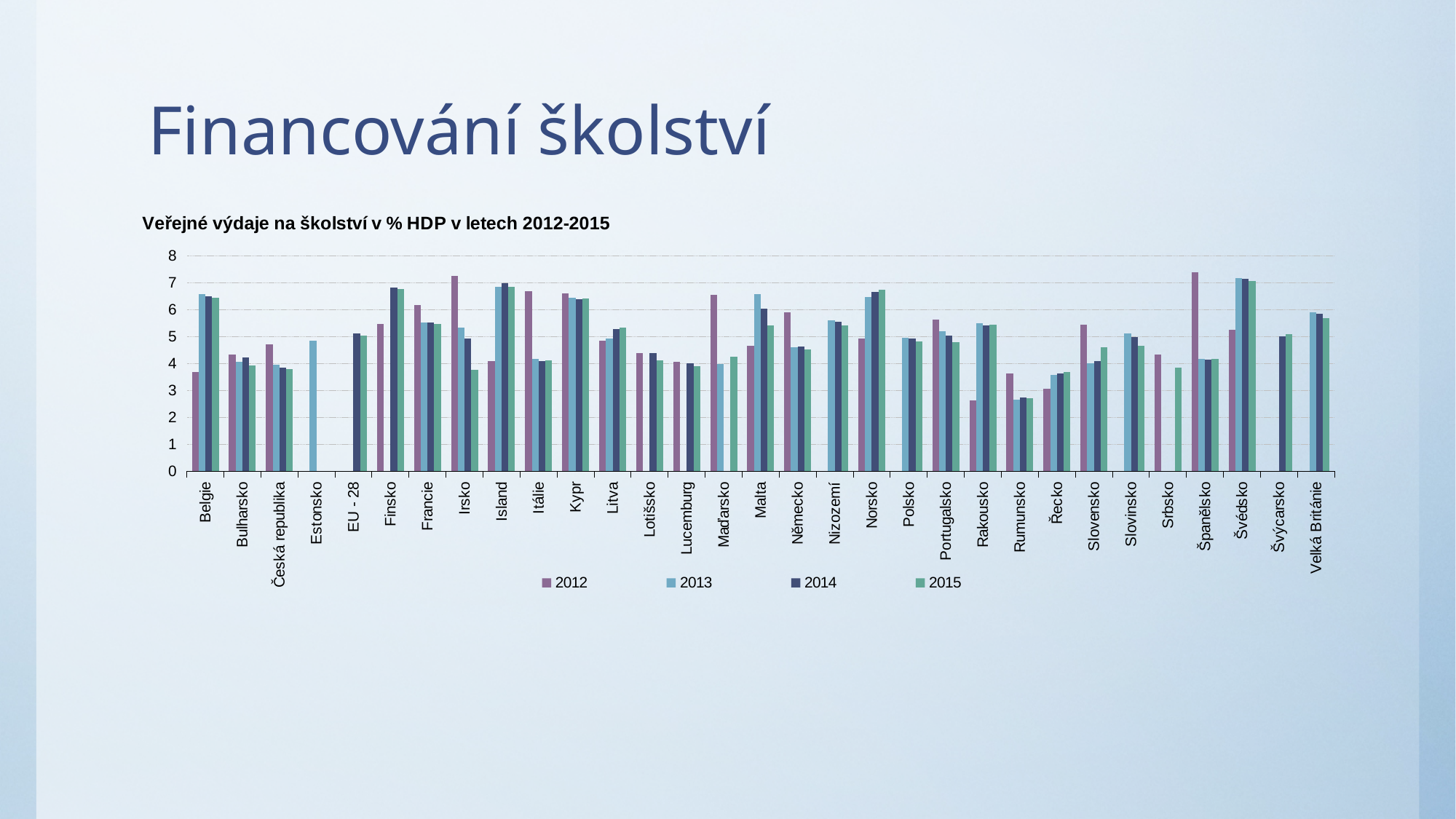
Is the 2013 value for Rumunsko greater or less than 3? less What is the title of the chart? Veřejné výdaje na školství v % HDP v letech 2012-2015 Do the values for Irsko rise or fall from 2012 to 2015? fall Is the 2014 value for Finsko greater or less than 6? greater For Belgie, which is larger: the 2012 value or the 2013 value? 2013 Which years are listed in the legend? 2012, 2013, 2014, 2015 Is the 2012 value for Španělsko greater or less than 7? greater How many series does the legend list? 4 What kind of chart is shown on the slide? bar chart How many countries/categories are shown on the x axis? 31 Which country has the lowest 2012 value? Rakousko